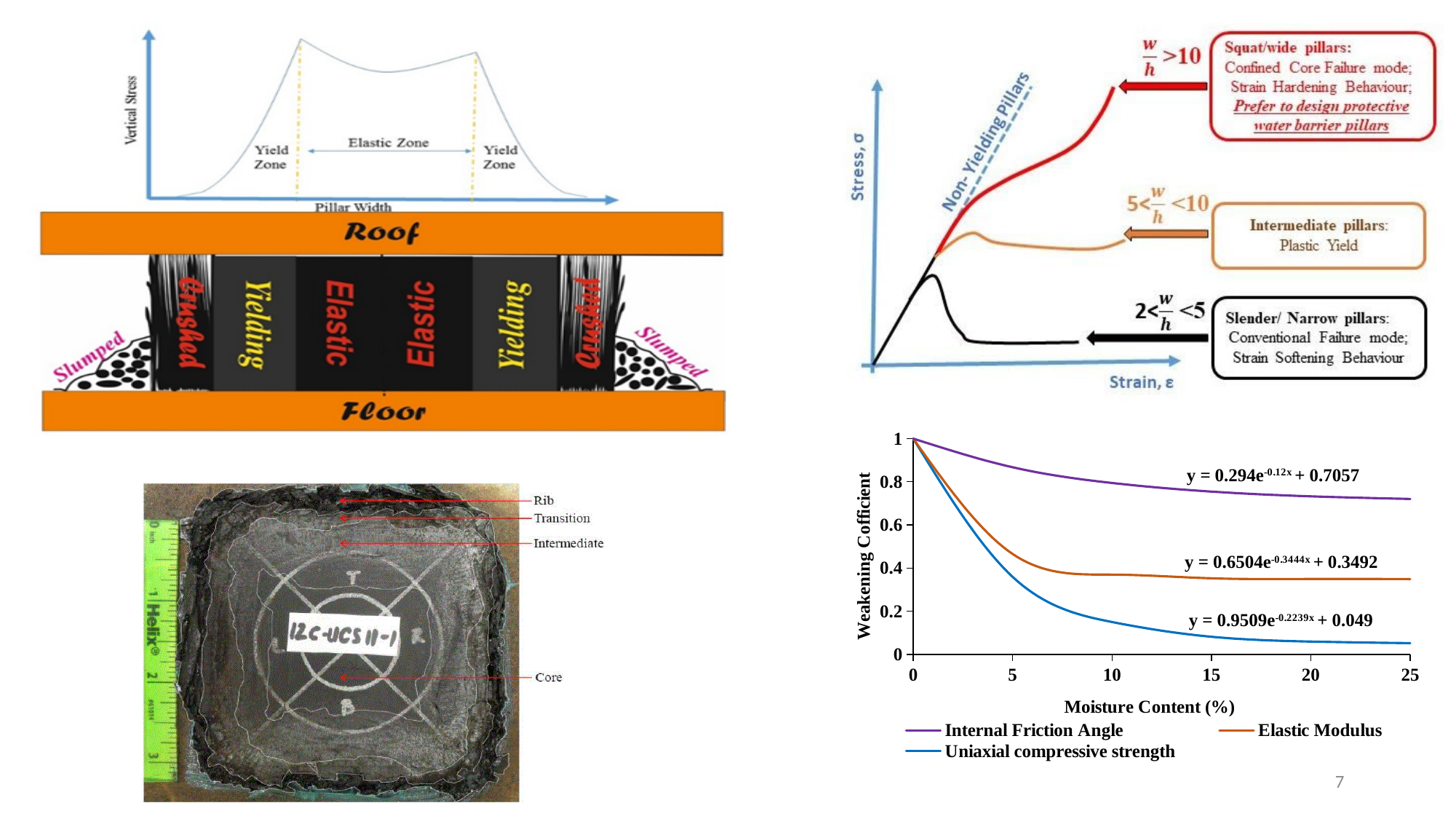
In the bottom-right chart of Weakening Coefficient versus Moisture Content, what kind of chart is it? Line chart In the bottom-right chart of Weakening Coefficient versus Moisture Content, which is larger at 10% moisture content: Elastic Modulus or Uniaxial compressive strength? Elastic Modulus In the bottom-right chart of Weakening Coefficient versus Moisture Content, what is the label of the x axis? Moisture Content (%) In the bottom-right chart of Weakening Coefficient versus Moisture Content, which series has the highest weakening coefficient at 25% moisture content? Internal Friction Angle In the bottom-right chart of Weakening Coefficient versus Moisture Content, is the value for Elastic Modulus at 25% moisture content greater or less than 0.4? less In the bottom-right chart of Weakening Coefficient versus Moisture Content, what fitted equation is shown for the Uniaxial compressive strength curve? y = 0.9509e^(-0.2239x) + 0.049 In the bottom-right chart of Weakening Coefficient versus Moisture Content, which series has the lowest weakening coefficient at 25% moisture content? Uniaxial compressive strength In the bottom-right chart of Weakening Coefficient versus Moisture Content, do the weakening coefficient values rise or fall as moisture content increases? Fall In the bottom-right chart of Weakening Coefficient versus Moisture Content, is the value for Internal Friction Angle at 25% moisture content greater or less than 0.6? greater In the bottom-right chart of Weakening Coefficient versus Moisture Content, is the value for Uniaxial compressive strength at 25% moisture content greater or less than 0.2? less In the bottom-right chart of Weakening Coefficient versus Moisture Content, how many series does the legend list? 3 In the bottom-right chart of Weakening Coefficient versus Moisture Content, what fitted equation is shown for the Internal Friction Angle curve? y = 0.294e^(-0.12x) + 0.7057